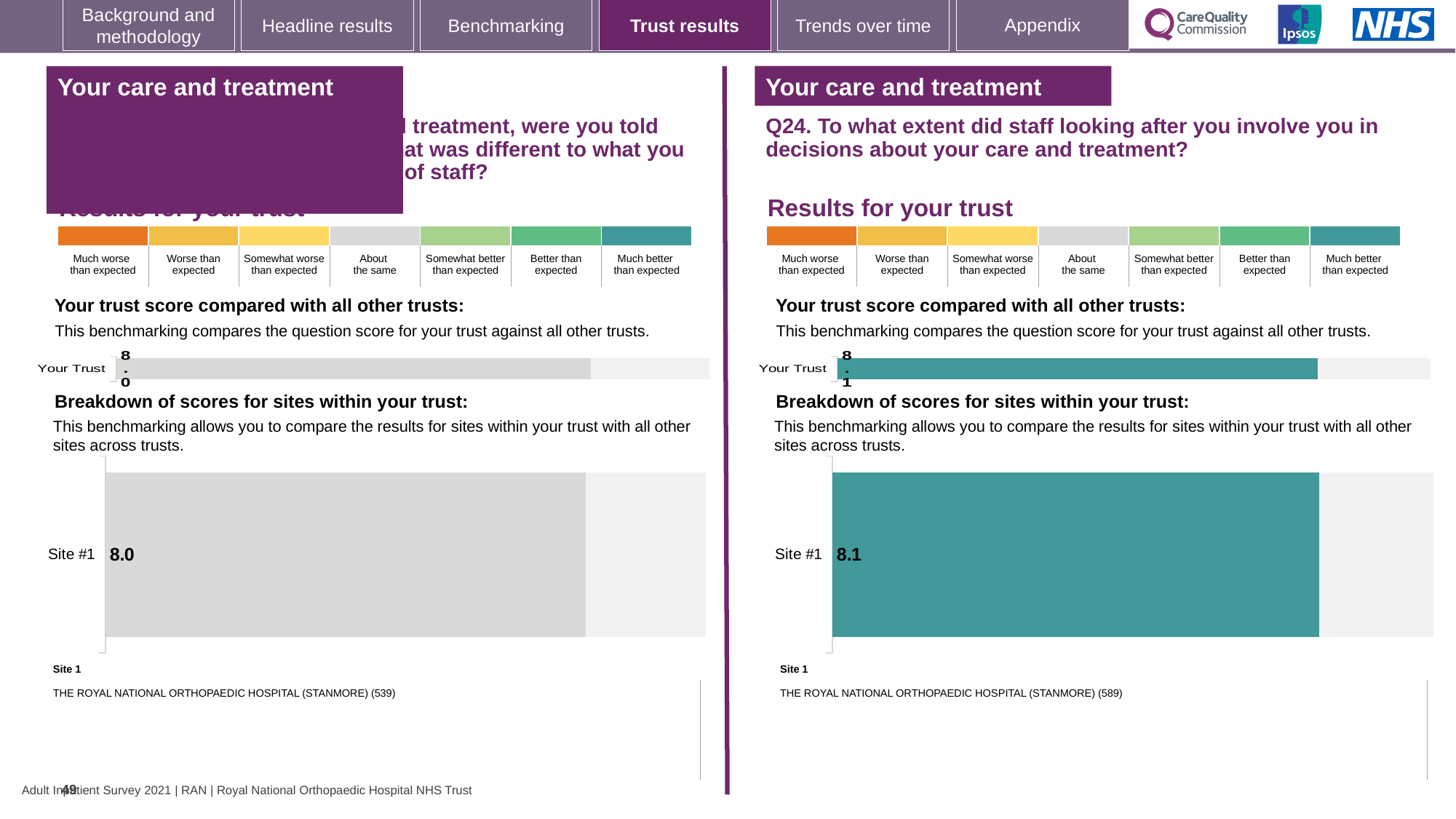
On the right-hand chart (Q24), what is the score shown for Your Trust? 8.1 What is the difference between the Your Trust score on the right-hand chart (Q24) and the Your Trust score on the left-hand chart? 0.1 How many sites are shown in the breakdown of scores for sites within your trust on the right-hand chart (Q24)? 1 On the left-hand chart, what is the score shown for Your Trust? 8.0 On the right-hand chart (Q24), what is the score for Site #1 in the breakdown of scores for sites within your trust? 8.1 What type of chart is used to show the breakdown of scores for sites within your trust on the right-hand side (Q24)? Bar chart How many sites are shown in the breakdown of scores for sites within your trust on the left-hand chart? 1 Which is larger: the Site #1 score on the left-hand chart or the Site #1 score on the right-hand chart (Q24)? Right-hand chart (Q24) On the right-hand chart (Q24), which benchmarking category does the colour of the Site #1 bar correspond to? Much better than expected On the left-hand chart, which benchmarking category does the colour of the Site #1 bar correspond to? About the same On the right-hand chart (Q24), what is the name of Site 1? THE ROYAL NATIONAL ORTHOPAEDIC HOSPITAL (STANMORE) (589) On the left-hand chart, what is the score for Site #1 in the breakdown of scores for sites within your trust? 8.0